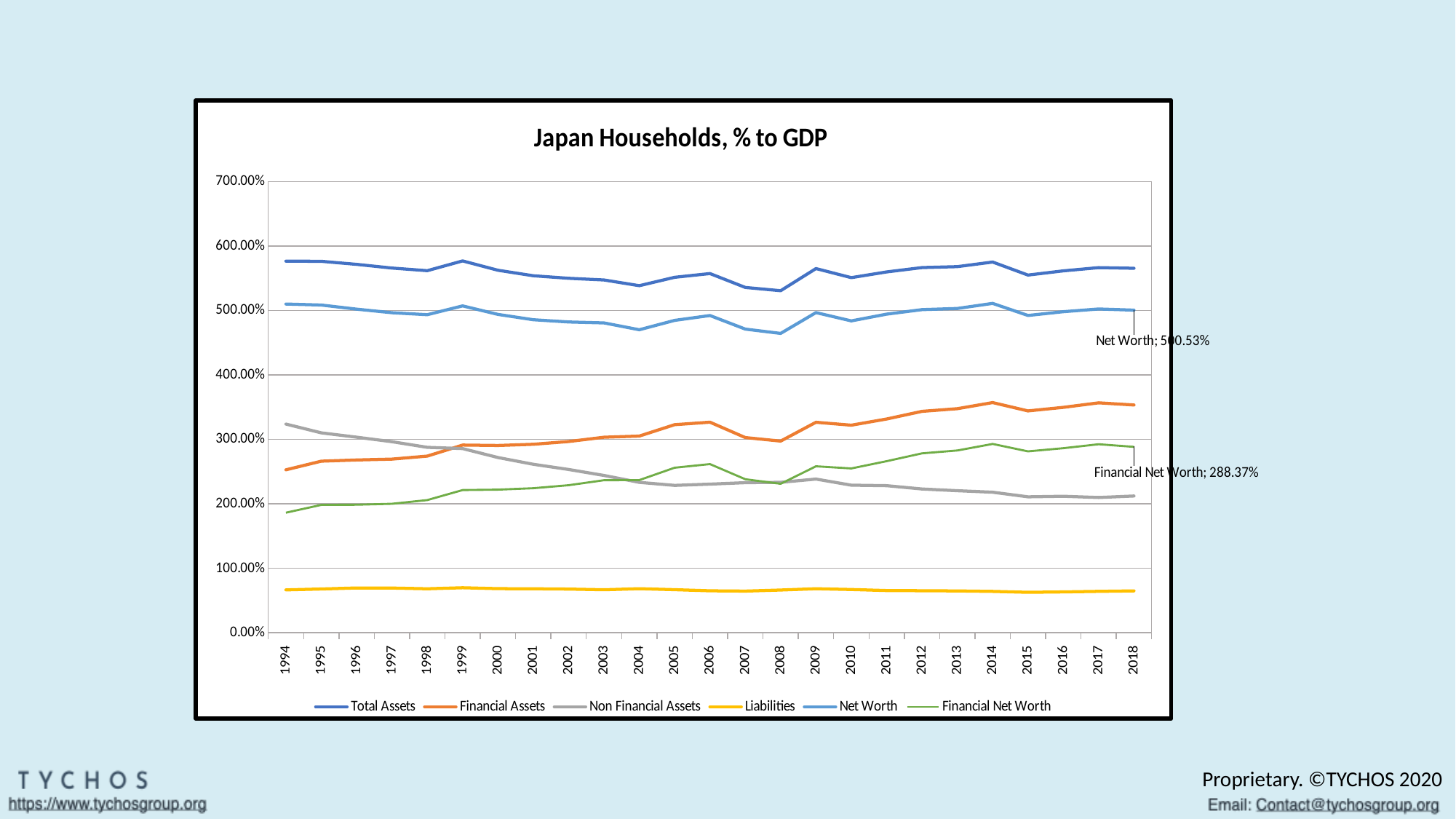
How many series does the legend list? 6 Is the value for Liabilities in 2018 greater or less than 100.00%? less Which series has the highest values across the whole period? Total Assets What is the difference between Net Worth and Financial Net Worth in 2018? 212.16% What is the value of Net Worth in 2018? 500.53% What is the title of the chart? Japan Households, % to GDP What kind of chart is shown on the slide? line chart Is the value for Total Assets in 1994 greater or less than 500.00%? greater Which series has the lowest values across the whole period? Liabilities What is the value of Financial Net Worth in 2018? 288.37% Do the values for Non Financial Assets rise or fall from 1994 to 2018? fall How many years are shown on the x axis? 25